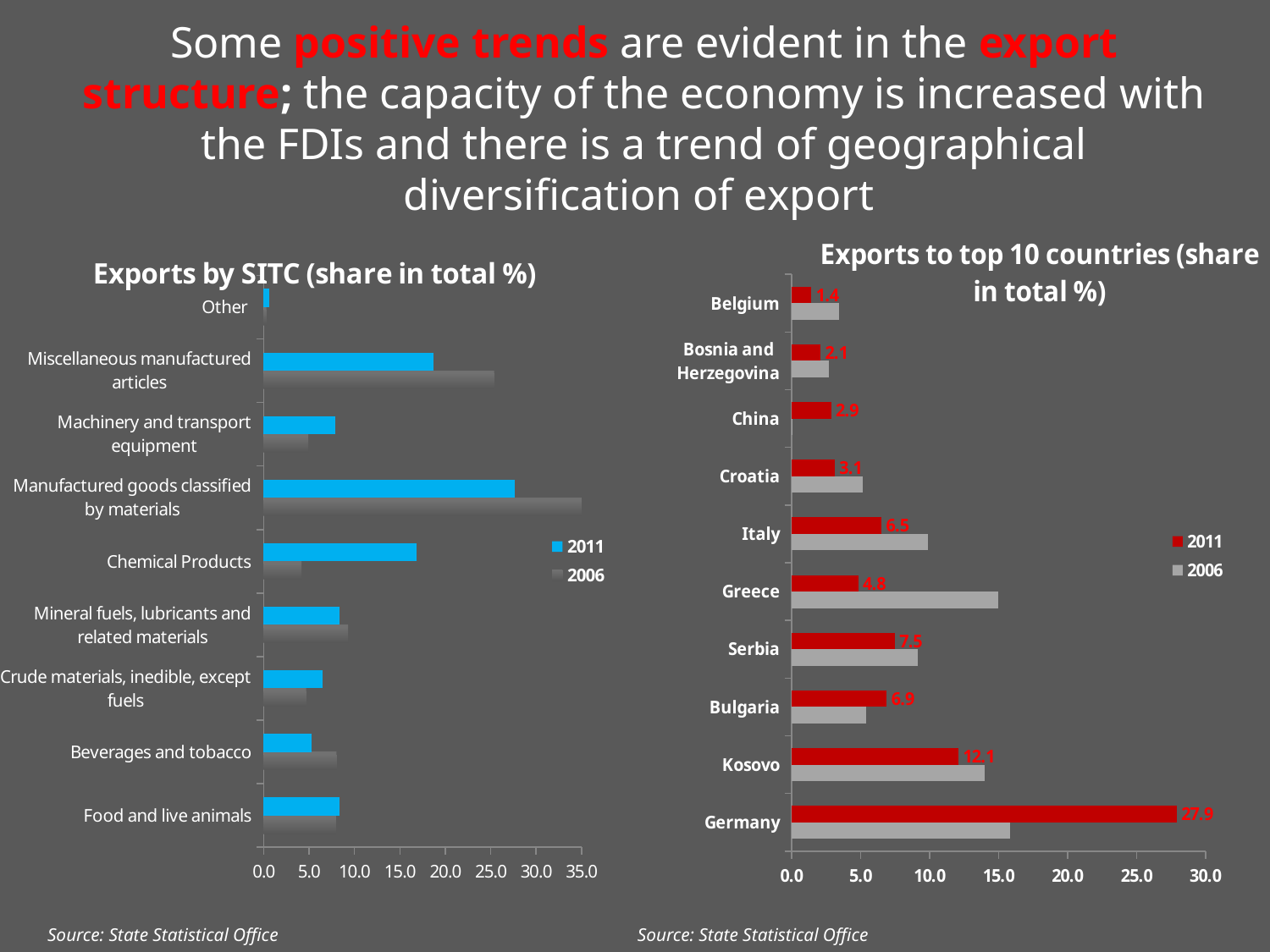
In the 'Exports to top 10 countries (share in total %)' chart, which country has the highest 2011 share? Germany In the 'Exports to top 10 countries (share in total %)' chart, what is the 2011 value for Kosovo? 12.1 In the 'Exports to top 10 countries (share in total %)' chart, which has the larger 2011 value, Serbia or Bulgaria? Serbia In the 'Exports to top 10 countries (share in total %)' chart, what is the difference between the 2011 values for Germany and Kosovo? 15.8 How many series does the legend of the 'Exports to top 10 countries (share in total %)' chart list? 2 In the 'Exports by SITC (share in total %)' chart, which category has the highest 2011 share? Manufactured goods classified by materials How many countries are shown in the 'Exports to top 10 countries (share in total %)' chart? 10 In the 'Exports to top 10 countries (share in total %)' chart, which country has the lowest 2011 share? Belgium In the 'Exports by SITC (share in total %)' chart, is the 2006 value for 'Manufactured goods classified by materials' greater or less than 30.0? greater In the 'Exports to top 10 countries (share in total %)' chart, is the 2006 value for Greece greater or less than 10.0? greater In the 'Exports to top 10 countries (share in total %)' chart, what is the 2011 value for Germany? 27.9 What kind of chart is 'Exports by SITC (share in total %)'? bar chart